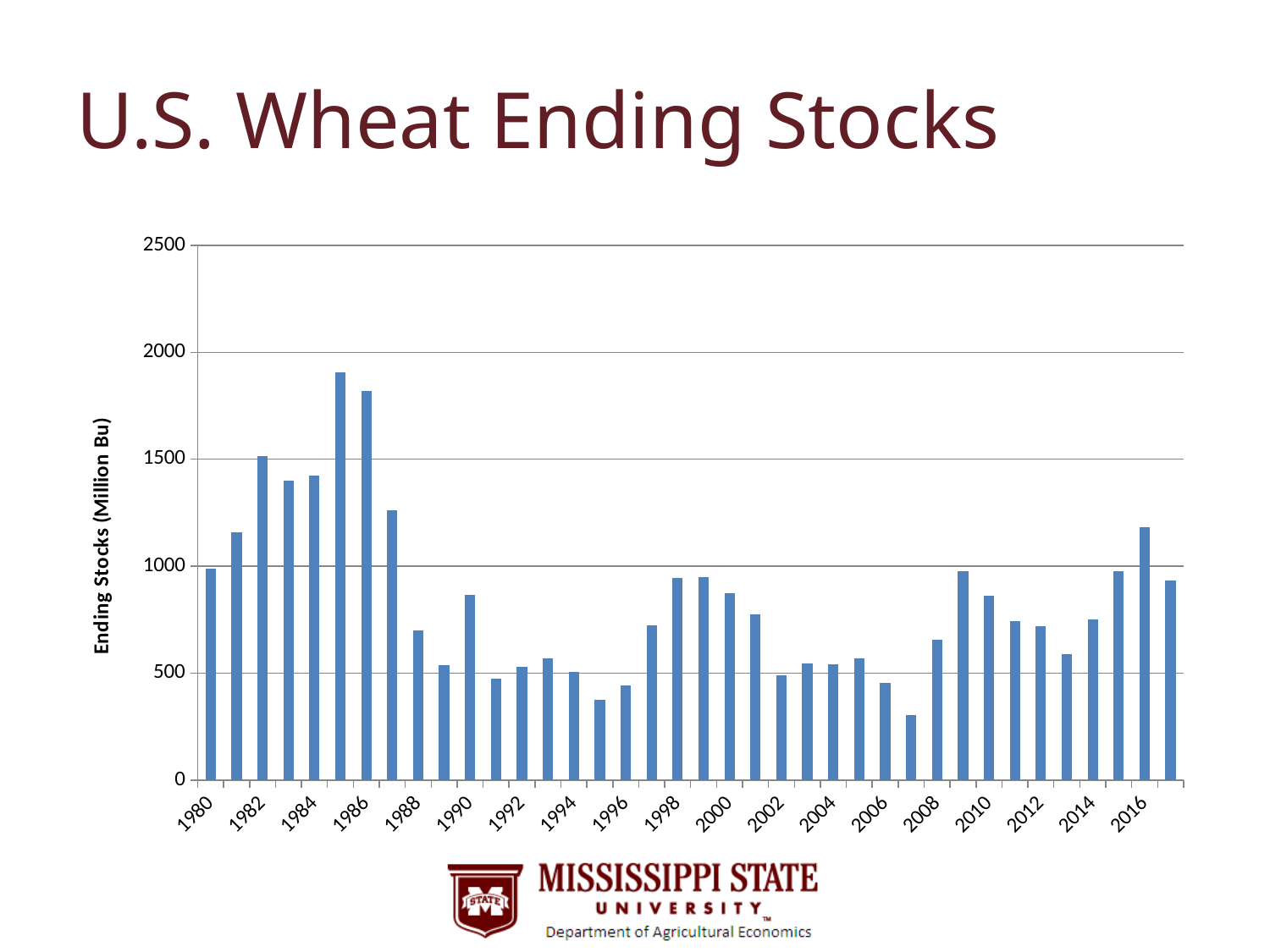
Do the ending stocks rise or fall from 1986 to 1989? fall Which year has higher ending stocks, 1982 or 1984? 1982 Is the value for 1990 greater or less than 1000? less Which year has the lowest U.S. wheat ending stocks? 2007 Is the value for 1988 greater or less than 500? greater Which year has the highest U.S. wheat ending stocks? 1985 What kind of chart is shown on the slide? Bar chart Which year has higher ending stocks, 2010 or 2016? 2016 Is the value for 2016 greater or less than 1000? greater What is the label on the vertical axis of the chart? Ending Stocks (Million Bu)